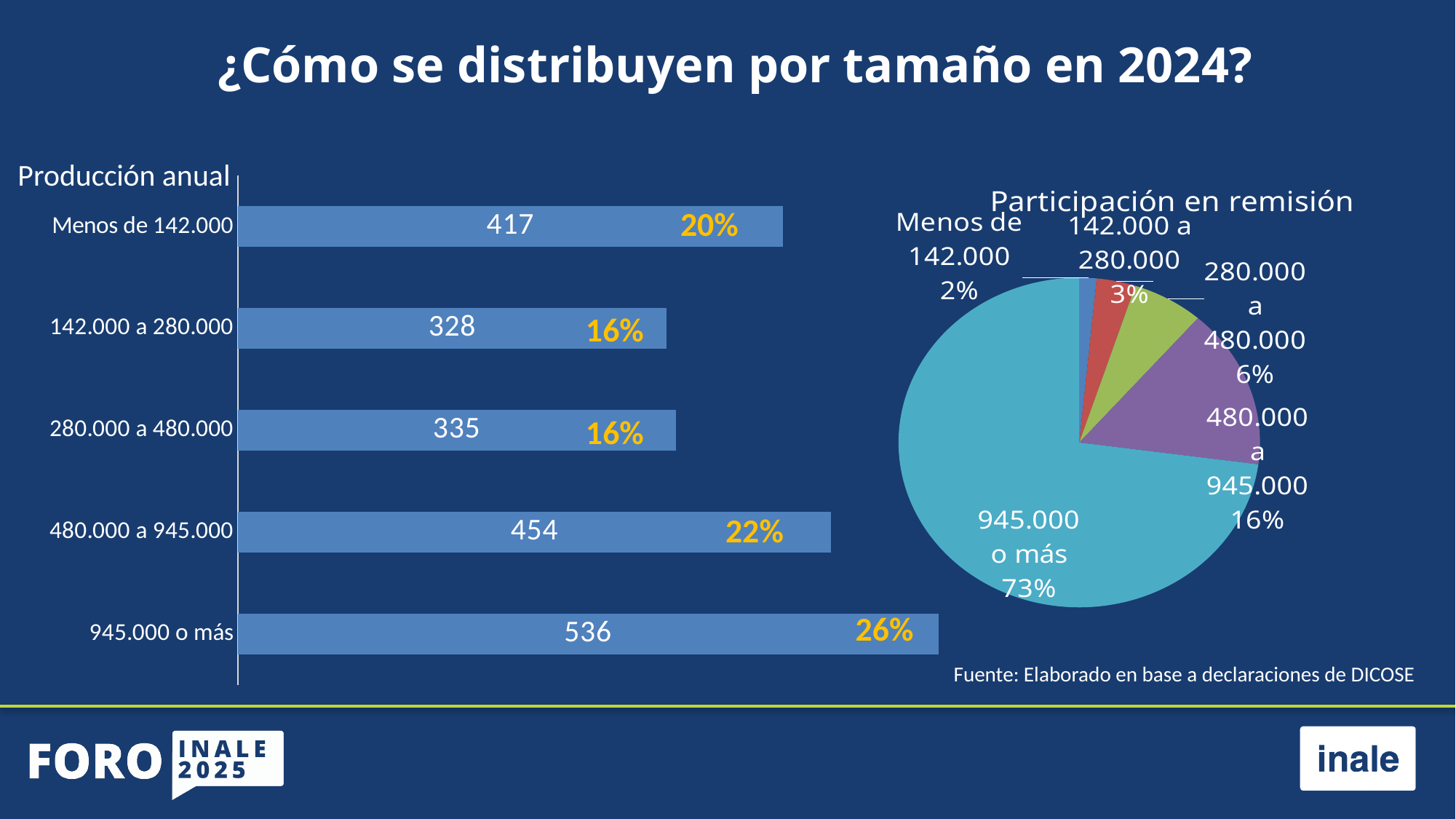
How many categories does the bar chart on the left show? 5 In the bar chart on the left, which category has the highest value? 945.000 o más In the pie chart "Participación en remisión", what share does the slice "280.000 a 480.000" have? 6% In the bar chart on the left, what is the value for the category "945.000 o más"? 536 In the bar chart on the left, which category has the lowest value? 142.000 a 280.000 What kind of chart is the chart on the left of the slide? Bar chart What is the title of the pie chart on the right of the slide? Participación en remisión In the bar chart on the left, which is larger: the value for "480.000 a 945.000" or the value for "Menos de 142.000"? 480.000 a 945.000 In the bar chart on the left, what is the value for the category "142.000 a 280.000"? 328 In the pie chart "Participación en remisión", what share does the slice "945.000 o más" have? 73% In the bar chart on the left, what percentage is shown next to the bar for "480.000 a 945.000"? 22% In the bar chart on the left, what is the difference between the values for "945.000 o más" and "Menos de 142.000"? 119